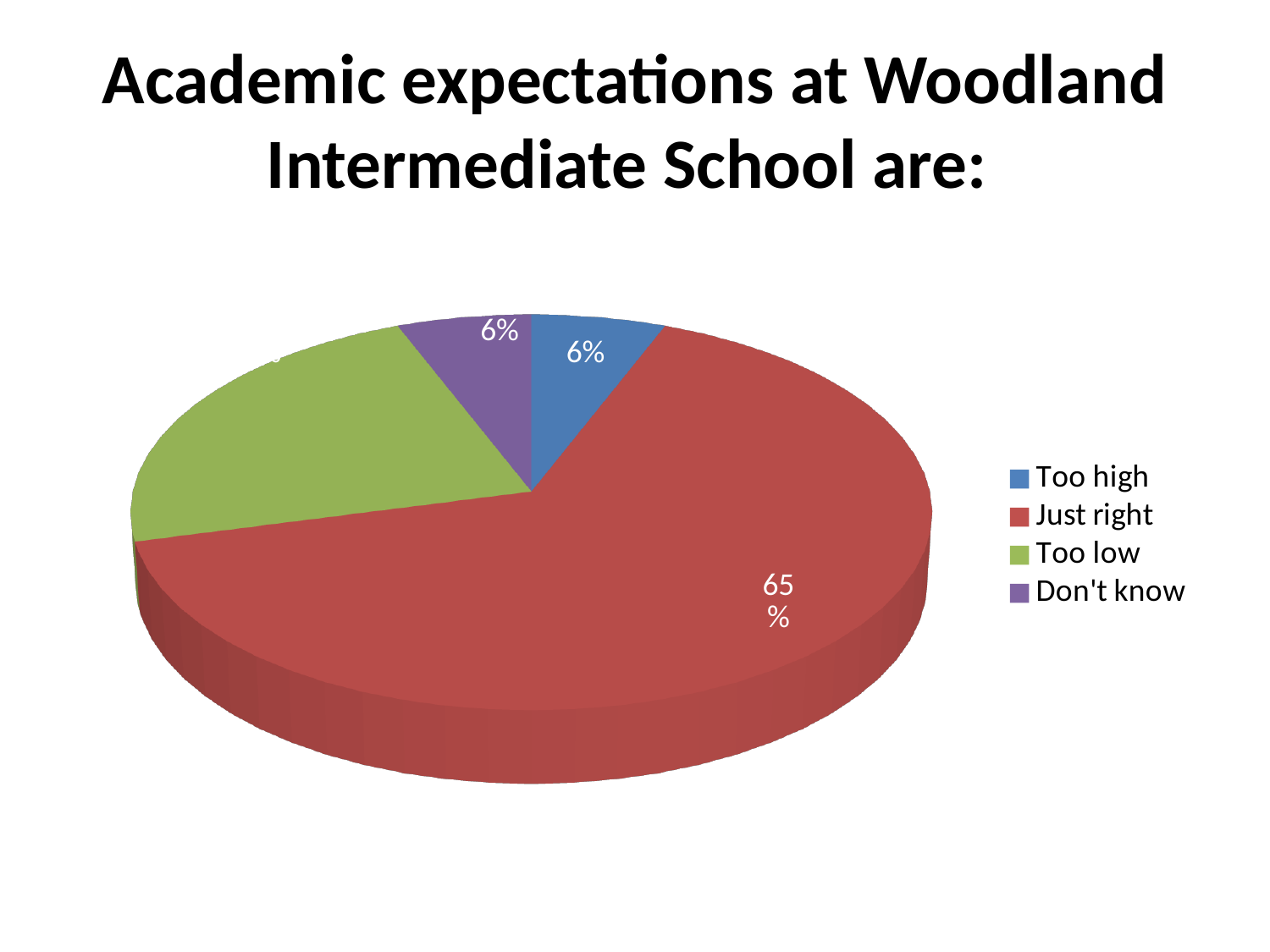
What percentage of respondents answered "Don't know"? 6% What is the title of the slide? Academic expectations at Woodland Intermediate School are: What is the difference between the "Just right" share and the "Too high" share? 59% How many entries does the legend list? 4 Which slice is larger, "Too low" or "Don't know"? Too low What percentage of respondents said academic expectations are "Just right"? 65% What percentage of respondents said academic expectations are "Too high"? 6% Which category has the largest share of the pie? Just right What colour is the "Too low" slice in the pie chart? Green Which slice is larger, "Just right" or "Too low"? Just right How many categories does the pie chart show? 4 What kind of chart is shown on the slide? Pie chart